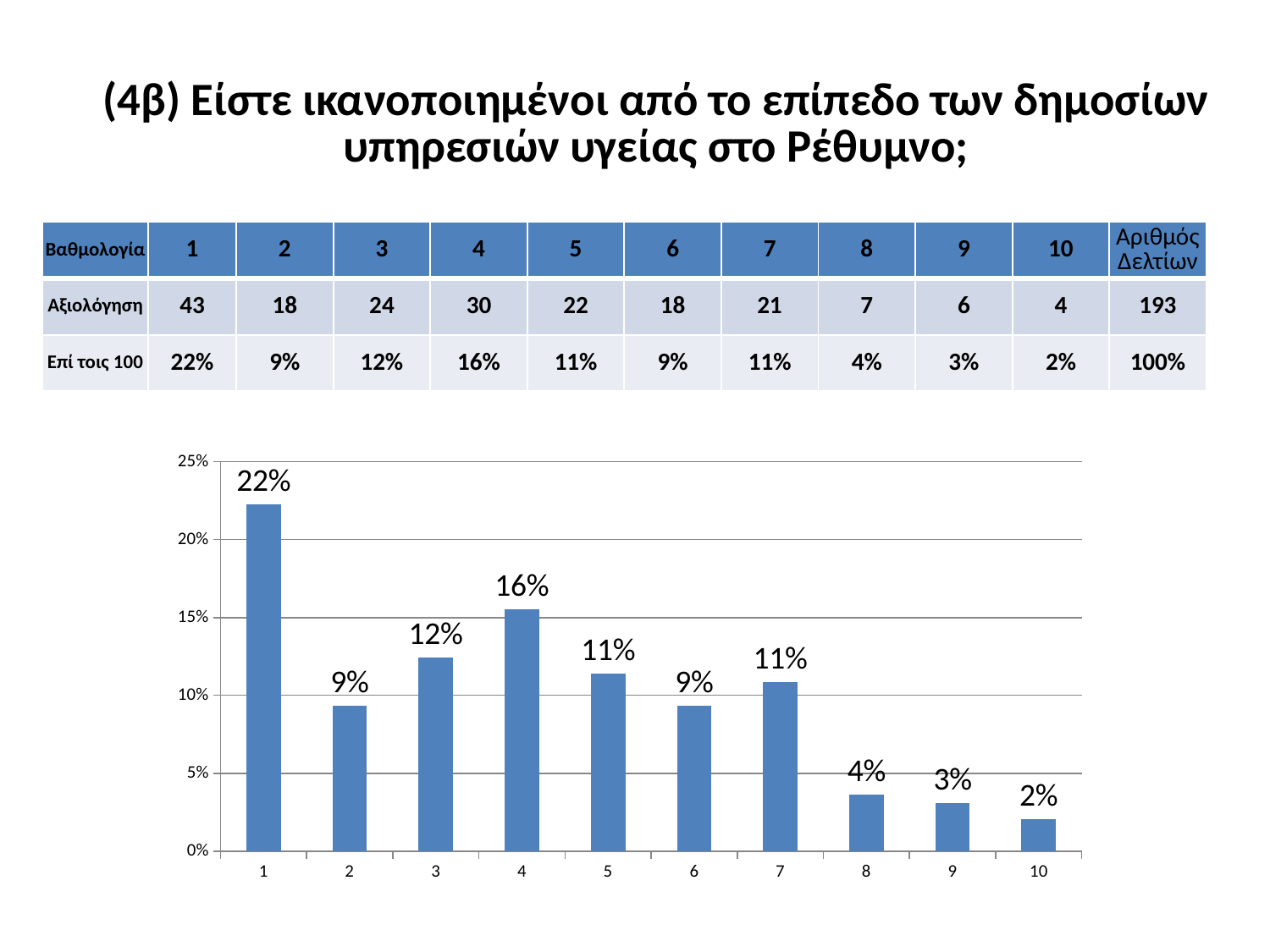
How many categories are shown on the x axis of the bar chart? 10 Which category has the lowest value in the bar chart? 10 Is the value for category 8 in the bar chart greater or less than 5%? less What is the highest value labelled on the y axis of the bar chart? 25% Which is larger in the bar chart, the value for category 3 or the value for category 6? category 3 What is the difference between the values for category 7 and category 9 in the bar chart? 8% Which category has the highest value in the bar chart? 1 What is the difference between the values for category 1 and category 4 in the bar chart? 6% What is the value shown for category 4 in the bar chart? 16% What is the value shown for category 10 in the bar chart? 2% What kind of chart is shown on the slide? bar chart What is the value shown for category 1 in the bar chart? 22%